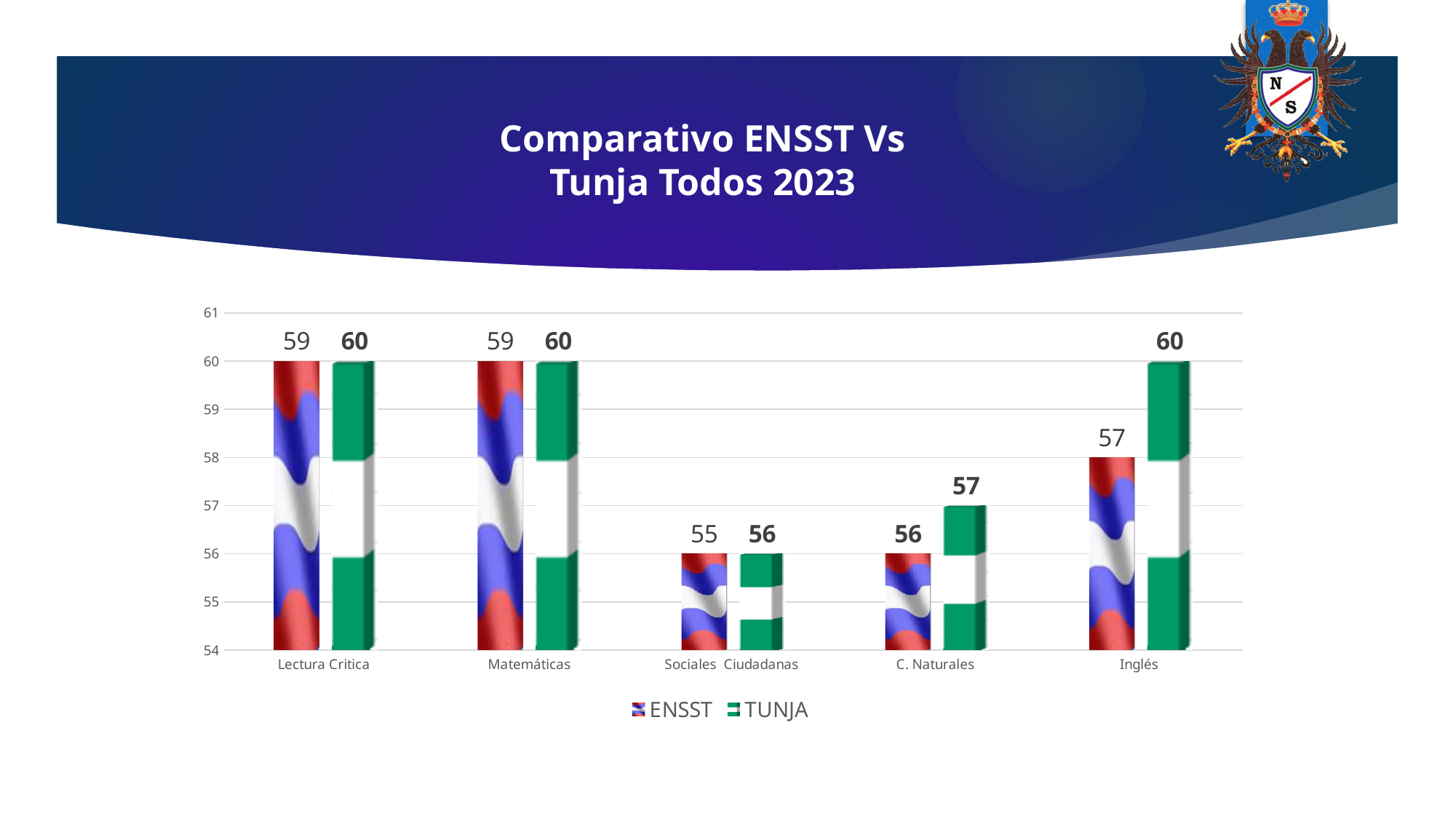
What is the TUNJA value for Inglés? 60 Which is larger for C. Naturales, the ENSST value or the TUNJA value? TUNJA What is the ENSST value for Lectura Critica? 59 Which category has the lowest TUNJA value? Sociales Ciudadanas What is the TUNJA value for C. Naturales? 57 How many series does the legend list? 2 Which category has the lowest ENSST value? Sociales Ciudadanas What is the difference between the TUNJA and ENSST values for Inglés? 3 What is the ENSST value for Sociales Ciudadanas? 55 What kind of chart is shown on the slide? Bar chart What is the title of the chart? Comparativo ENSST Vs Tunja Todos 2023 How many categories are shown on the x axis? 5